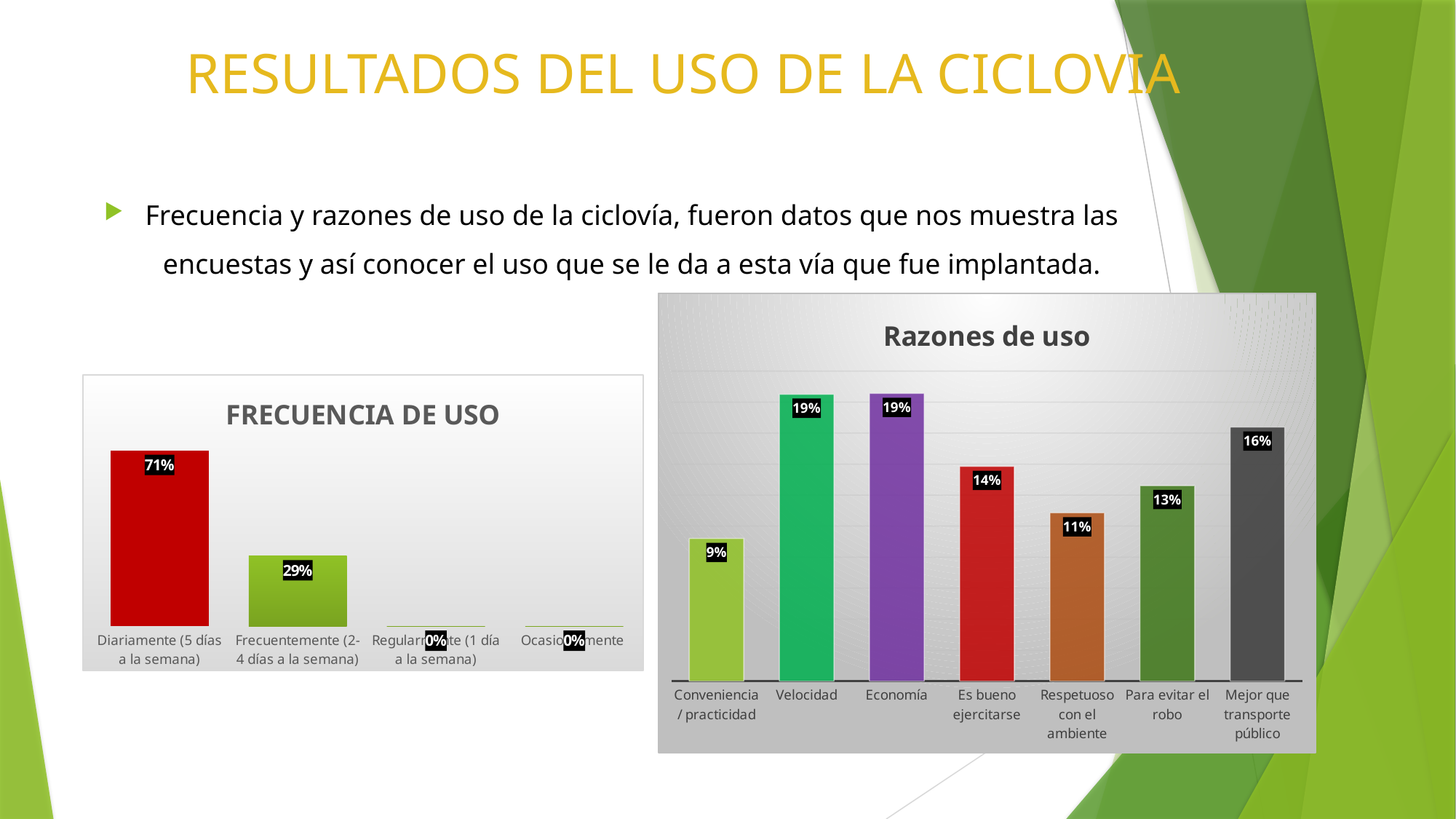
In the FRECUENCIA DE USO chart, what is the difference between Diariamente and Frecuentemente? 42% In the Razones de uso chart, which category has the lowest value? Conveniencia / practicidad What type of chart is the Razones de uso chart? Bar chart In the Razones de uso chart, what is the difference between Economía and Para evitar el robo? 6% In the Razones de uso chart, what is the value for Mejor que transporte público? 16% In the FRECUENCIA DE USO chart, what is the value for Diariamente (5 días a la semana)? 71% In the FRECUENCIA DE USO chart, what is the value for Frecuentemente (2-4 días a la semana)? 29% In the Razones de uso chart, what is the value for Velocidad? 19% In the Razones de uso chart, which is larger: Es bueno ejercitarse or Respetuoso con el ambiente? Es bueno ejercitarse In the FRECUENCIA DE USO chart, which category has the highest value? Diariamente (5 días a la semana) How many categories are shown in the Razones de uso chart? 7 How many categories are shown in the FRECUENCIA DE USO chart? 4